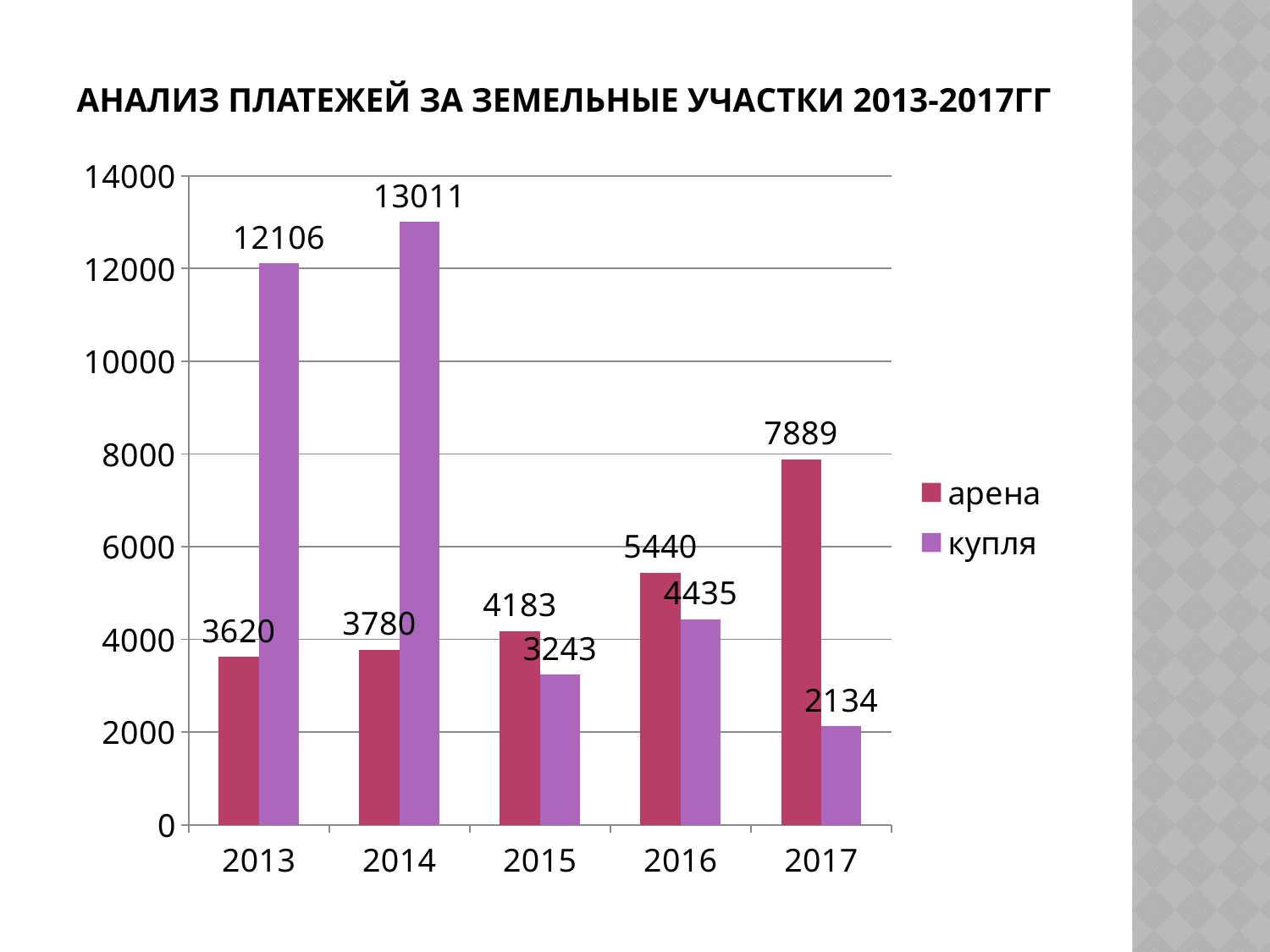
Which is larger in 2016, арена or купля? арена What is the value for купля in 2017? 2134 Does the арена value rise or fall from 2013 to 2017? rise What kind of chart is shown on the slide? bar chart What is the value for арена in 2017? 7889 How many years are shown on the x axis? 5 In which year is the арена value lowest? 2013 In which year is the купля value highest? 2014 What is the difference between купля and арена in 2013? 8486 What is the title of the chart? АНАЛИЗ ПЛАТЕЖЕЙ ЗА ЗЕМЕЛЬНЫЕ УЧАСТКИ 2013-2017ГГ What is the value for купля in 2014? 13011 How many series does the legend list? 2